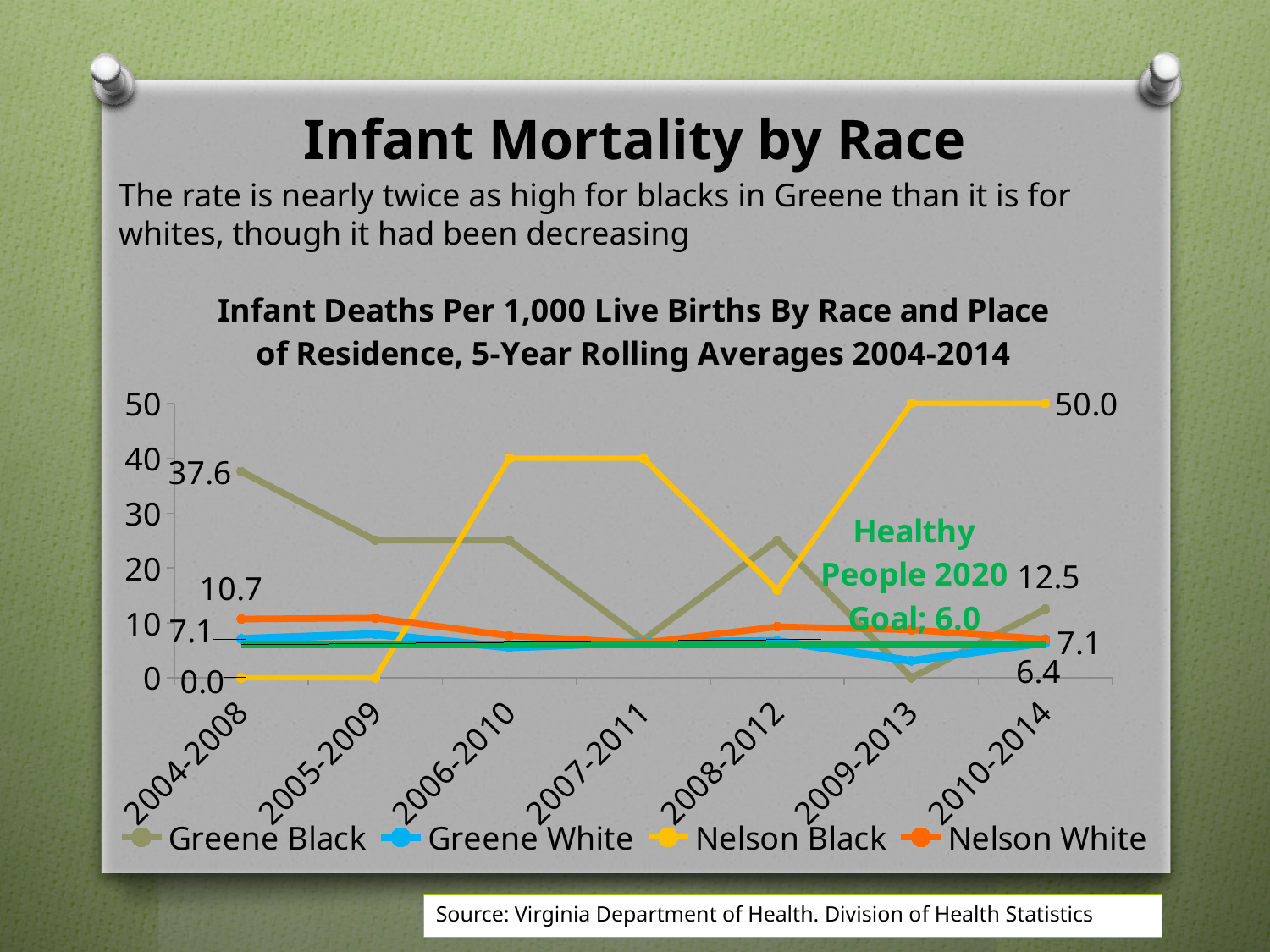
What is the value for Nelson Black in 2004-2008? 0.0 What kind of chart is shown on the slide? line chart What is the Healthy People 2020 Goal value marked on the chart? 6.0 What is the value for Greene Black in 2010-2014? 12.5 What is the value for Nelson Black in 2010-2014? 50.0 Which series has the highest value in 2010-2014? Nelson Black By how much did the Greene Black value fall from 2004-2008 to 2010-2014? 25.1 How many time periods are shown on the x axis? 7 Is the value for Nelson Black in 2006-2010 greater or less than 30? greater How many series does the legend list? 4 What is the value for Nelson White in 2004-2008? 10.7 What is the value for Greene Black in 2004-2008? 37.6